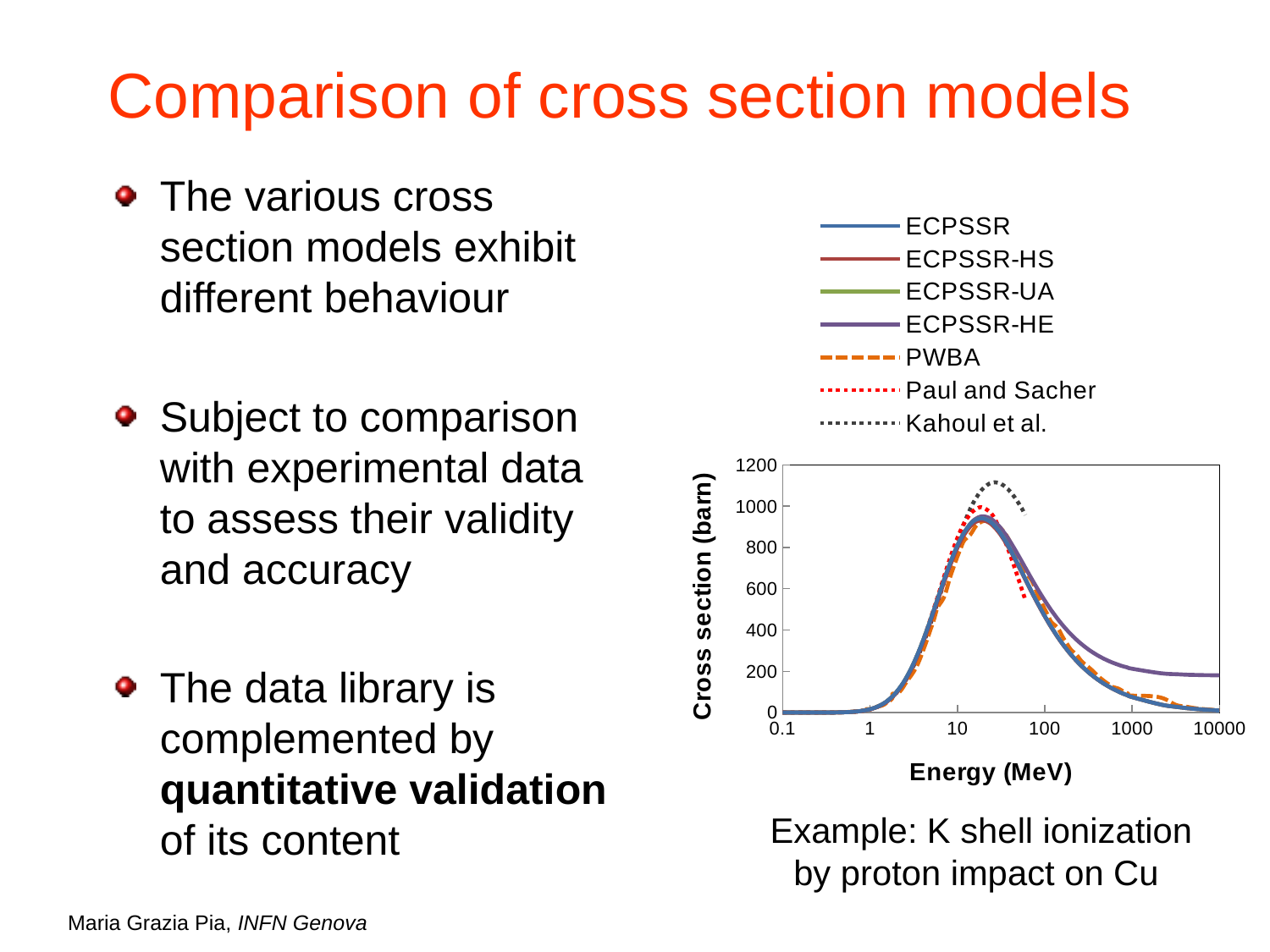
What kind of chart is shown on the slide? line chart Is the value of the ECPSSR curve at 1 MeV greater or less than 200 barn? less Which series reaches the highest peak cross section in the chart? Kahoul et al. Is the peak value of the Kahoul et al. curve greater or less than 1000 barn? greater Is the peak value of the ECPSSR curve greater or less than 1000 barn? less Between 100 MeV and 1000 MeV, does the ECPSSR curve rise or fall as energy increases? fall Which series is drawn as an orange dashed line in the chart? PWBA Which series has the highest cross section at 10000 MeV? ECPSSR-HE At 1000 MeV, which is larger: the ECPSSR-HE value or the ECPSSR value? ECPSSR-HE How many series does the legend of the chart list? 7 What is the label of the vertical axis of the chart? Cross section (barn)